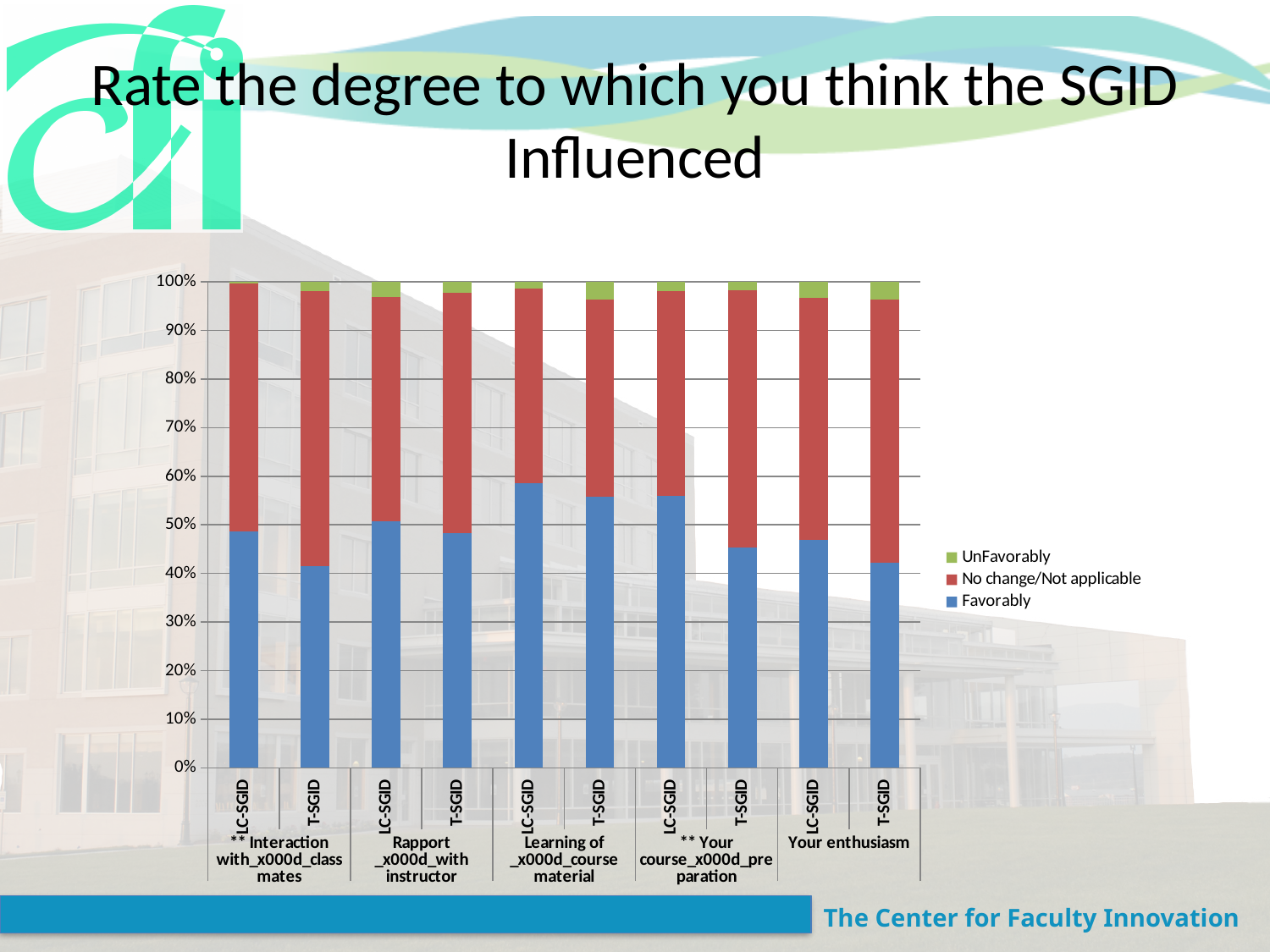
Which colour represents the 'Favorably' series in the chart? Blue How many category groups (survey items) are shown along the x axis? 5 Is the Favorably value for LC-SGID under '** Your course preparation' greater or less than 50%? greater How many bars are plotted in the chart? 10 Is the Favorably value for T-SGID under 'Your enthusiasm' greater or less than 50%? less For '** Interaction with classmates', which has the larger Favorably share, LC-SGID or T-SGID? LC-SGID Is the Favorably value for T-SGID under '** Interaction with classmates' greater or less than 50%? less For '** Your course preparation', which has the larger Favorably share, LC-SGID or T-SGID? LC-SGID What is the title of the slide containing the chart? Rate the degree to which you think the SGID Influenced What kind of chart is shown on the slide? Stacked bar chart How many series does the legend list? 3